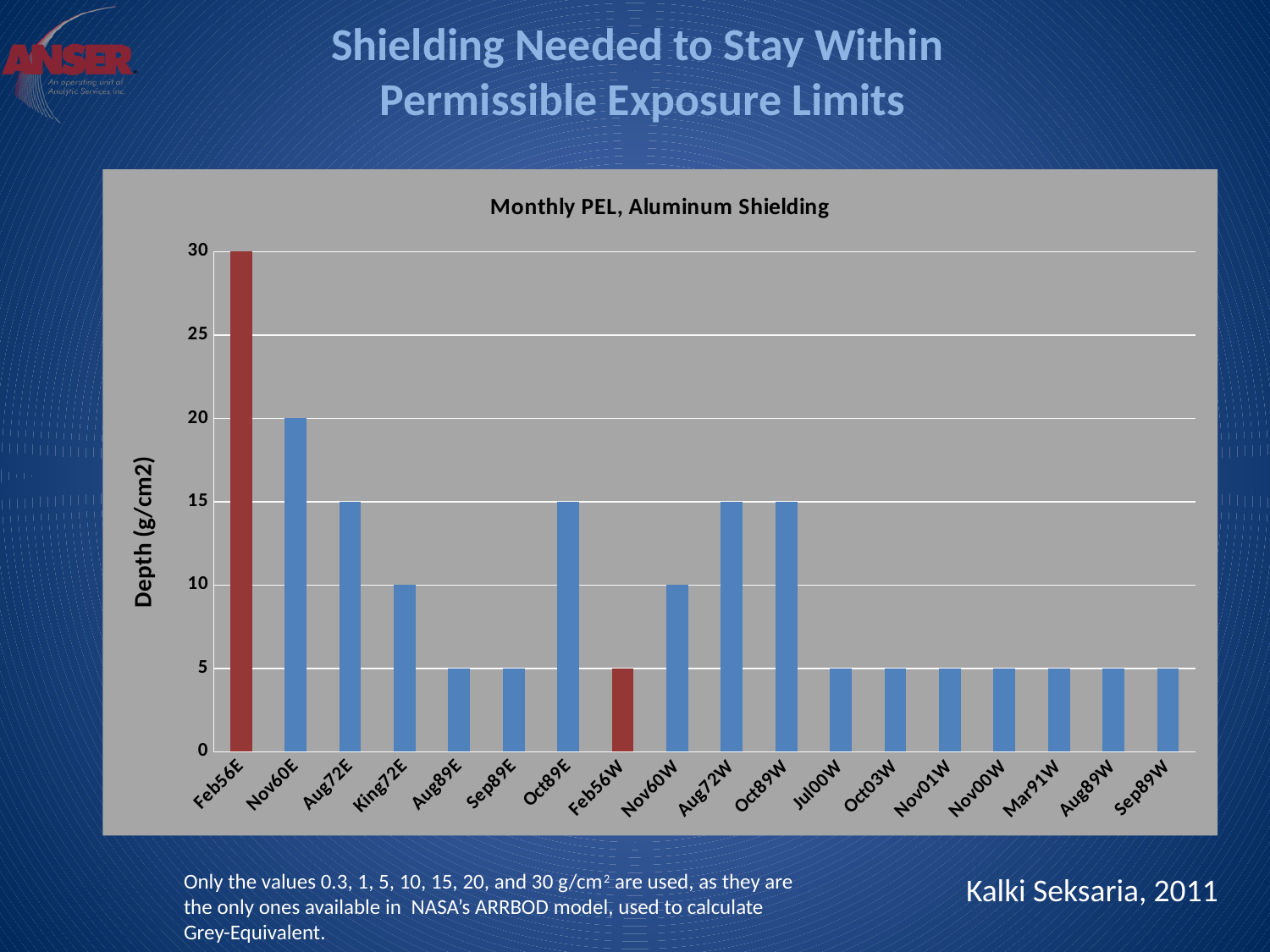
How many categories are plotted on the x axis? 18 What is the value for King72E? 10 Which is larger, the value for Aug72E or the value for Nov60W? Aug72E What type of chart is shown on the slide? bar chart What is the difference between the values for Feb56E and Nov60E? 10 What is the y-axis label of the chart? Depth (g/cm2) What is the value for Nov60E? 20 What is the value for Feb56E? 30 Is the value for Oct89W greater or less than 10? greater Which category has the highest value? Feb56E What is the title of the chart? Monthly PEL, Aluminum Shielding What is the value for Feb56W? 5